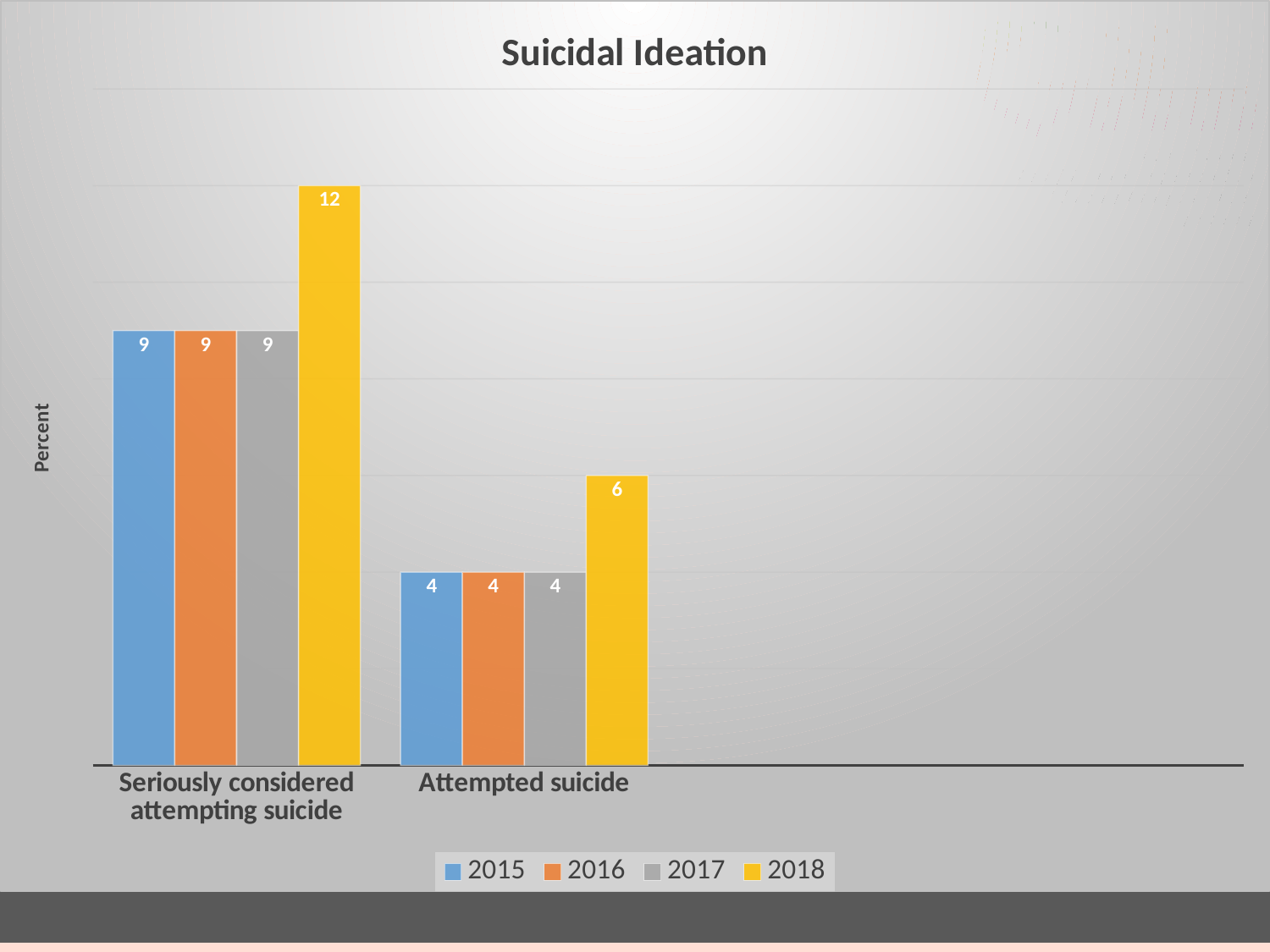
What is the value for 2018 in the 'Attempted suicide' category? 6 How many categories are shown on the x axis? 2 What is the difference between the 2018 and 2016 values for 'Attempted suicide'? 2 What is the title of the chart? Suicidal Ideation What is the difference between the 2018 and 2017 values for 'Seriously considered attempting suicide'? 3 What kind of chart is shown on the slide? Bar chart What is the value for 2017 in the 'Seriously considered attempting suicide' category? 9 Which is larger: the 2018 value for 'Seriously considered attempting suicide' or the 2018 value for 'Attempted suicide'? Seriously considered attempting suicide What is the value for 2018 in the 'Seriously considered attempting suicide' category? 12 What is the value for 2015 in the 'Attempted suicide' category? 4 Which year has the highest value in the 'Attempted suicide' category? 2018 How many series does the legend list? 4